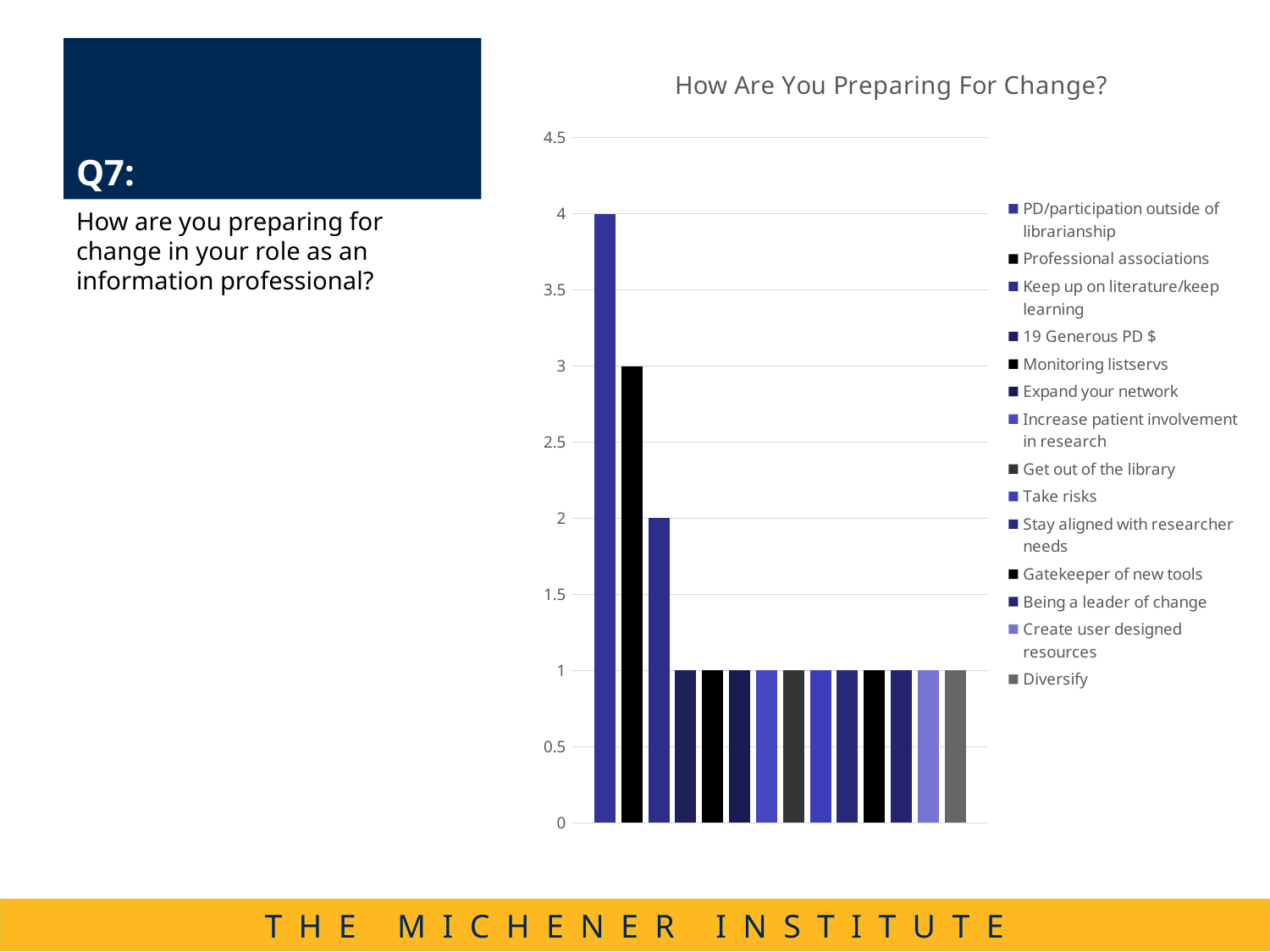
Which series has the highest value in the chart? PD/participation outside of librarianship What is the difference between the values for PD/participation outside of librarianship and Professional associations? 1 Is the value for PD/participation outside of librarianship greater or less than 3.5? greater How many bars are plotted in the chart? 14 What type of chart is shown on the slide? Bar chart Which is larger, the value for Professional associations or the value for Keep up on literature/keep learning? Professional associations What is the value for Professional associations? 3 What is the title of the chart? How Are You Preparing For Change? What is the value for Diversify? 1 What is the value for Keep up on literature/keep learning? 2 What is the value for PD/participation outside of librarianship? 4 How many series does the chart's legend list? 14